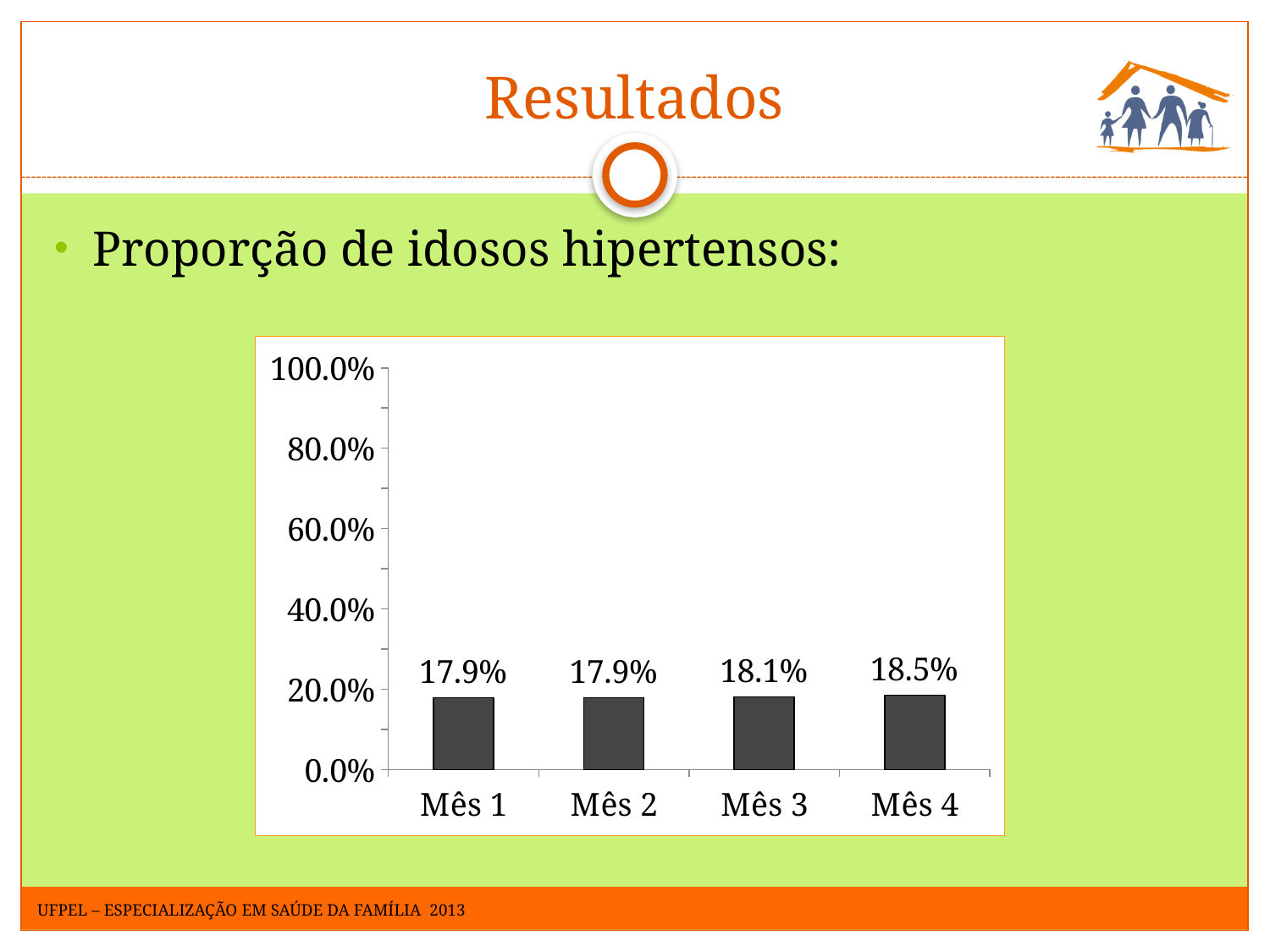
Which is larger, the value for Mês 4 or the value for Mês 2? Mês 4 Which month has the highest value? Mês 4 What is the value for Mês 3? 18.1% Do the values rise or fall from Mês 1 to Mês 4? rise What is the value for Mês 4? 18.5% How many months are shown on the x axis? 4 Is the value for Mês 2 greater or less than 20.0%? less What kind of chart is shown? bar chart What is the difference between the values for Mês 3 and Mês 2? 0.2% What is the highest value shown on the y axis? 100.0% What is the value for Mês 1? 17.9% What is the difference between the values for Mês 4 and Mês 1? 0.6%